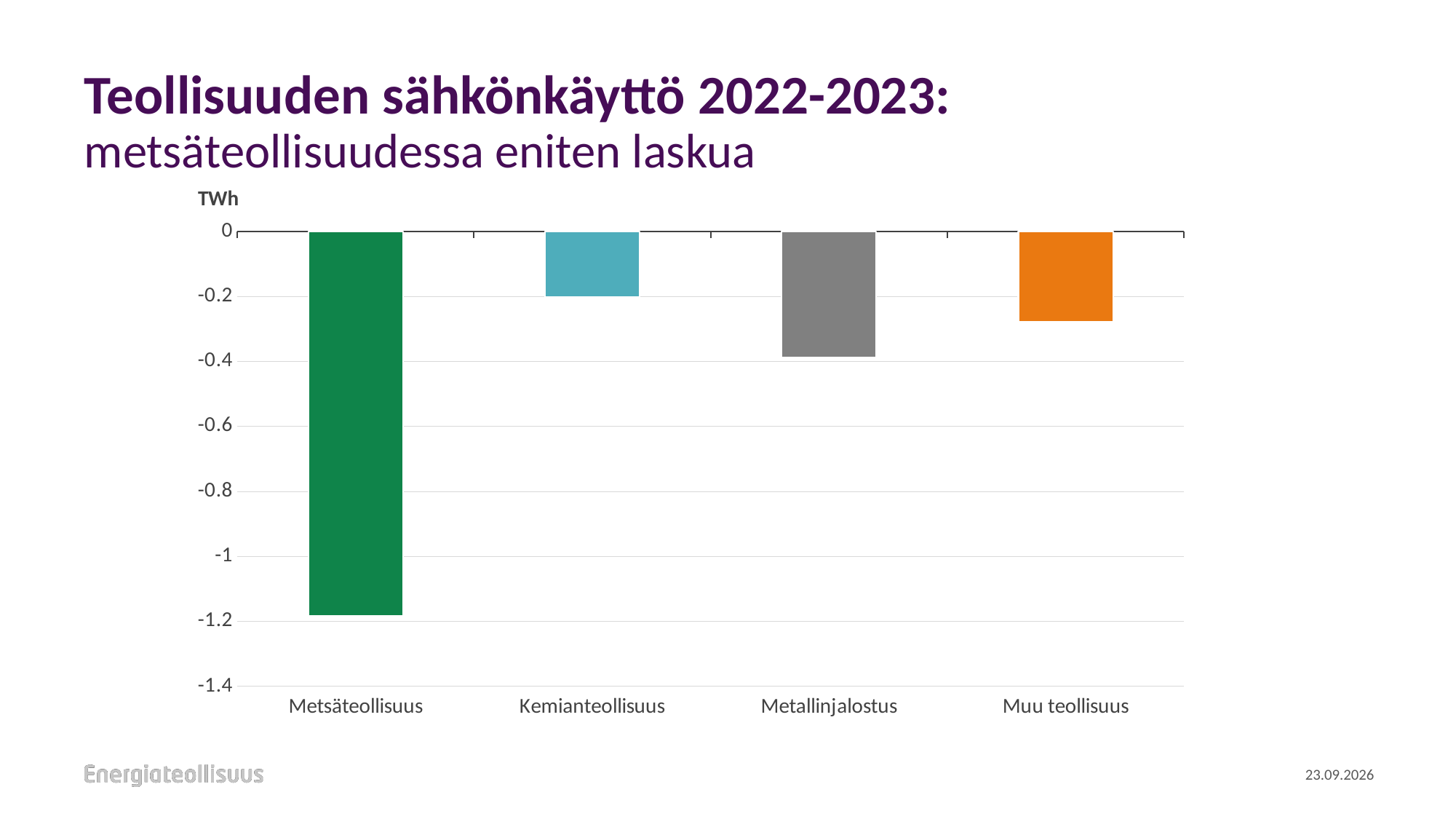
What unit is shown on the vertical axis of the chart? TWh Which has the larger value, Metallinjalostus or Muu teollisuus? Muu teollisuus Which has the larger value, Kemianteollisuus or Metallinjalostus? Kemianteollisuus How many industry categories are plotted in the chart? 4 Is the value for Muu teollisuus greater or less than -0.4? greater Is the value for Metsäteollisuus greater or less than -1? less What kind of chart is shown on the slide? bar chart Is the value for Kemianteollisuus greater or less than -0.4? greater What is the lowest tick value shown on the vertical axis? -1.4 Which category has the lowest (most negative) value? Metsäteollisuus Which category has the highest value (closest to zero)? Kemianteollisuus